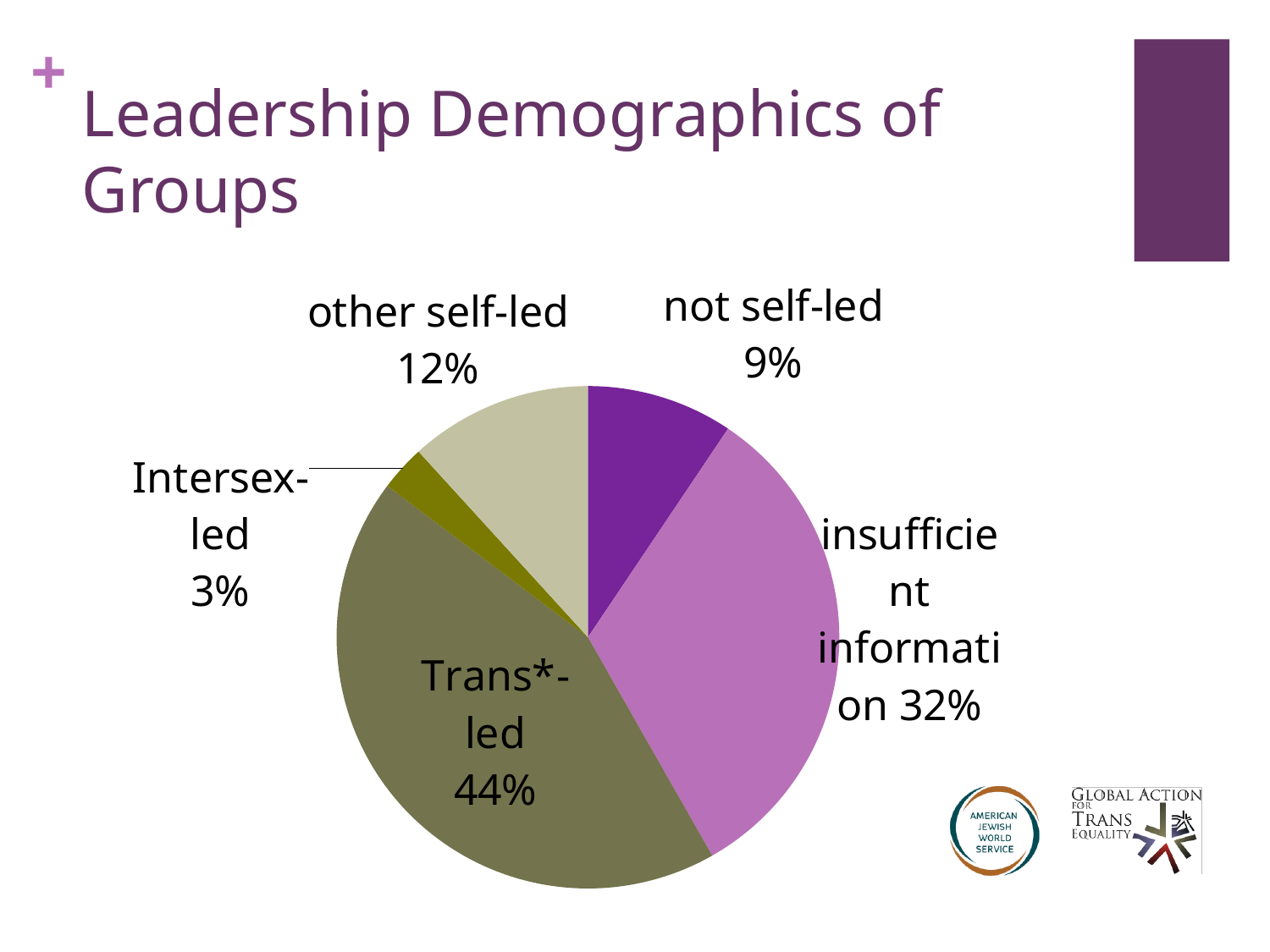
What is the difference in percentage points between Trans*-led and insufficient information? 12 Which category has the smallest slice of the pie? Intersex-led Which is larger, the share for 'other self-led' or the share for 'not self-led'? other self-led What share of groups are 'other self-led'? 12% What share of groups are Trans*-led? 44% What kind of chart is shown on the slide? pie chart What share of groups fall under 'insufficient information'? 32% What share of groups are not self-led? 9% What is the title of the slide containing the pie chart? Leadership Demographics of Groups How many slices does the pie chart have? 5 Which category has the largest slice of the pie? Trans*-led What share of groups are Intersex-led? 3%